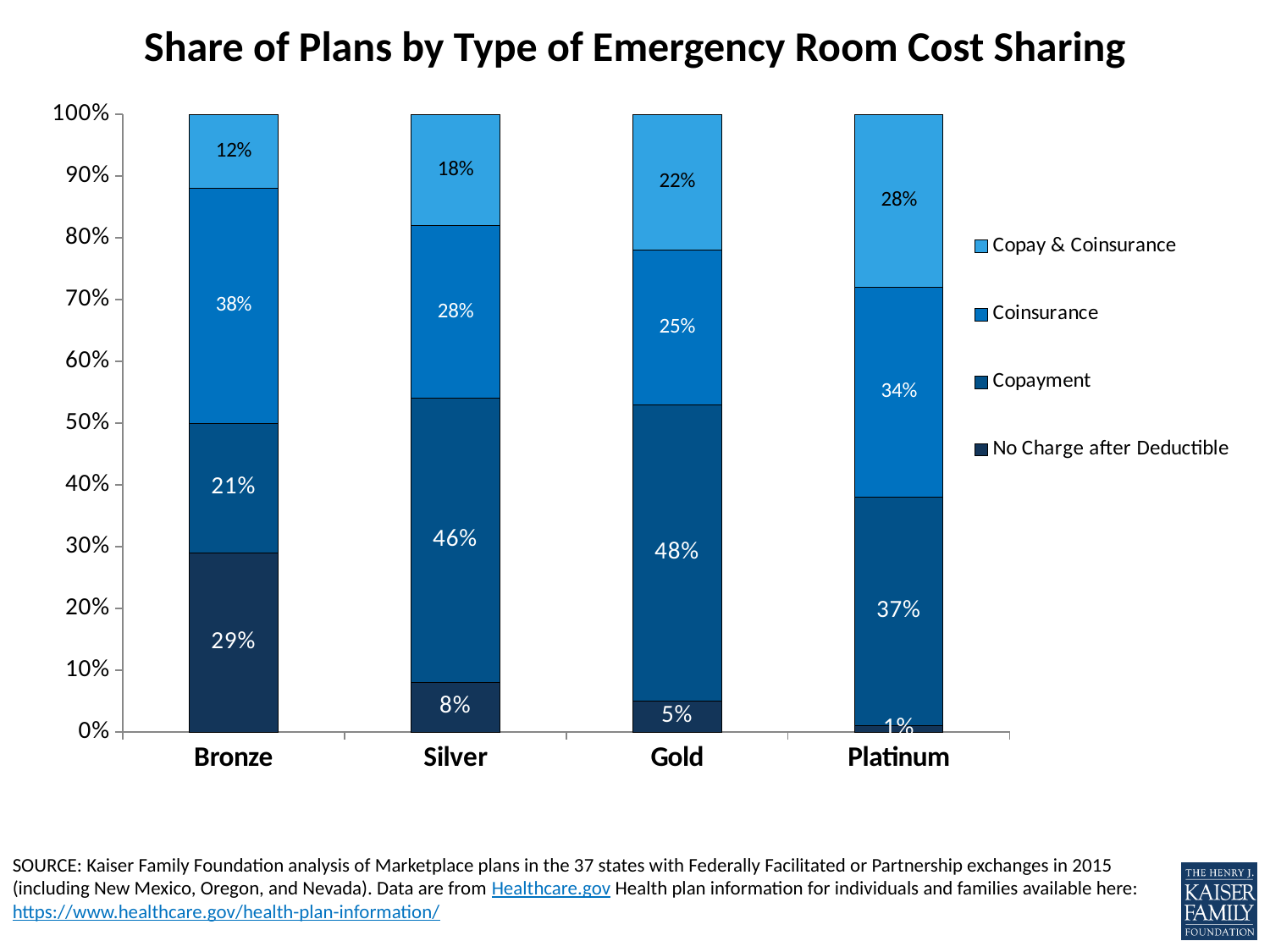
How many plan types are shown on the x axis? 4 What is the Coinsurance share for Platinum plans? 34% Does the Copay & Coinsurance share rise or fall from Bronze to Platinum? Rise Which is larger: the Coinsurance share for Bronze or for Gold? Bronze How many series does the legend list? 4 What share of Bronze plans have No Charge after Deductible for emergency room cost sharing? 29% Which plan type has the lowest No Charge after Deductible share? Platinum What kind of chart is shown on the slide? Stacked bar chart What is the Copay & Coinsurance share for Silver plans? 18% What is the Copayment share for Gold plans? 48% What is the difference between the Copayment share for Silver and for Bronze? 25% Which plan type has the highest Copay & Coinsurance share? Platinum